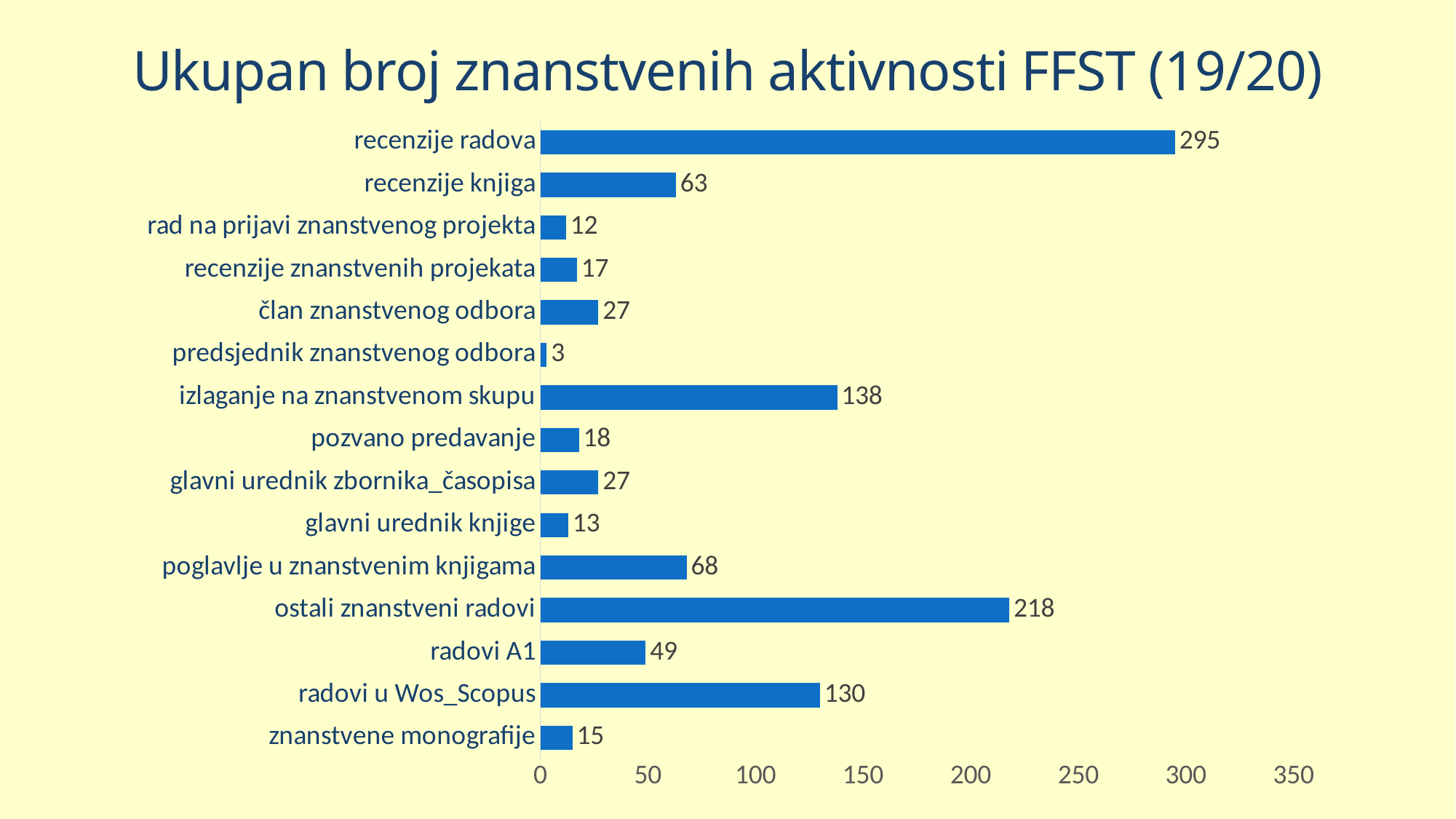
What is the value for "izlaganje na znanstvenom skupu"? 138 What is the value for "radovi u Wos_Scopus"? 130 What is the value for "radovi A1"? 49 What is the title of the chart? Ukupan broj znanstvenih aktivnosti FFST (19/20) Is the value for "ostali znanstveni radovi" greater or less than 200? greater What is the difference between "recenzije radova" and "ostali znanstveni radovi"? 77 Which category has the highest value? recenzije radova What kind of chart is shown on the slide? bar chart What is the value for "recenzije radova"? 295 How many categories are shown in the chart? 15 Which category has the lowest value? predsjednik znanstvenog odbora Which is larger, "poglavlje u znanstvenim knjigama" or "recenzije knjiga"? poglavlje u znanstvenim knjigama